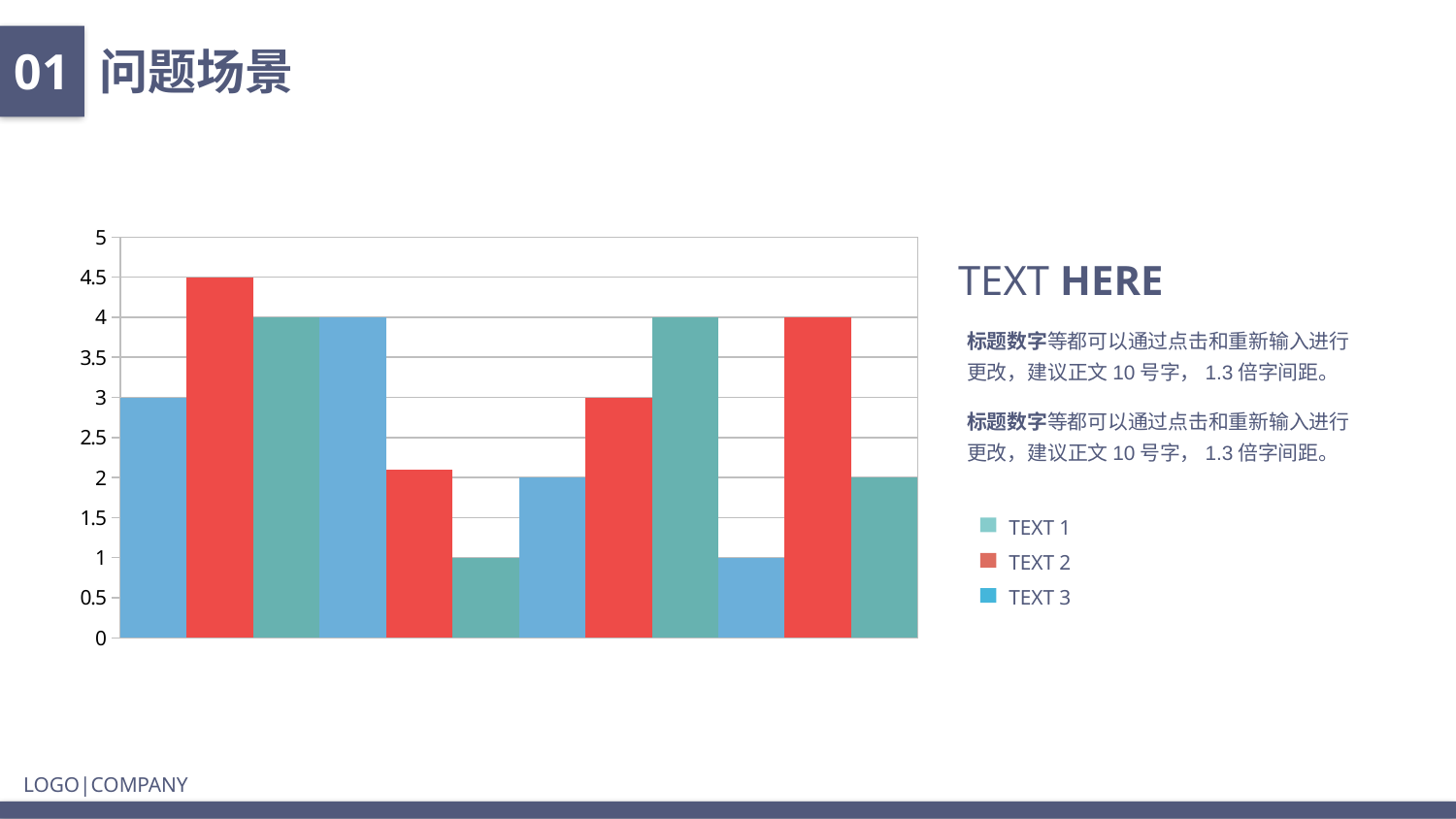
Which is larger, the second bar from the left or the first bar from the left? the second bar How many bars are plotted in the chart? 12 What is the highest value shown on the vertical axis? 5 What are the three entries listed in the legend? TEXT 1, TEXT 2, TEXT 3 Is the value of the last bar on the right greater or less than 3? less What kind of chart is shown on the slide? bar chart Is the value of the second bar from the left greater or less than 4? greater How many series does the legend list? 3 Is the value of the first bar from the left greater or less than 2? greater What is the value of the shortest bars in the chart? 1 What is the value of the tallest bar in the chart? 4.5